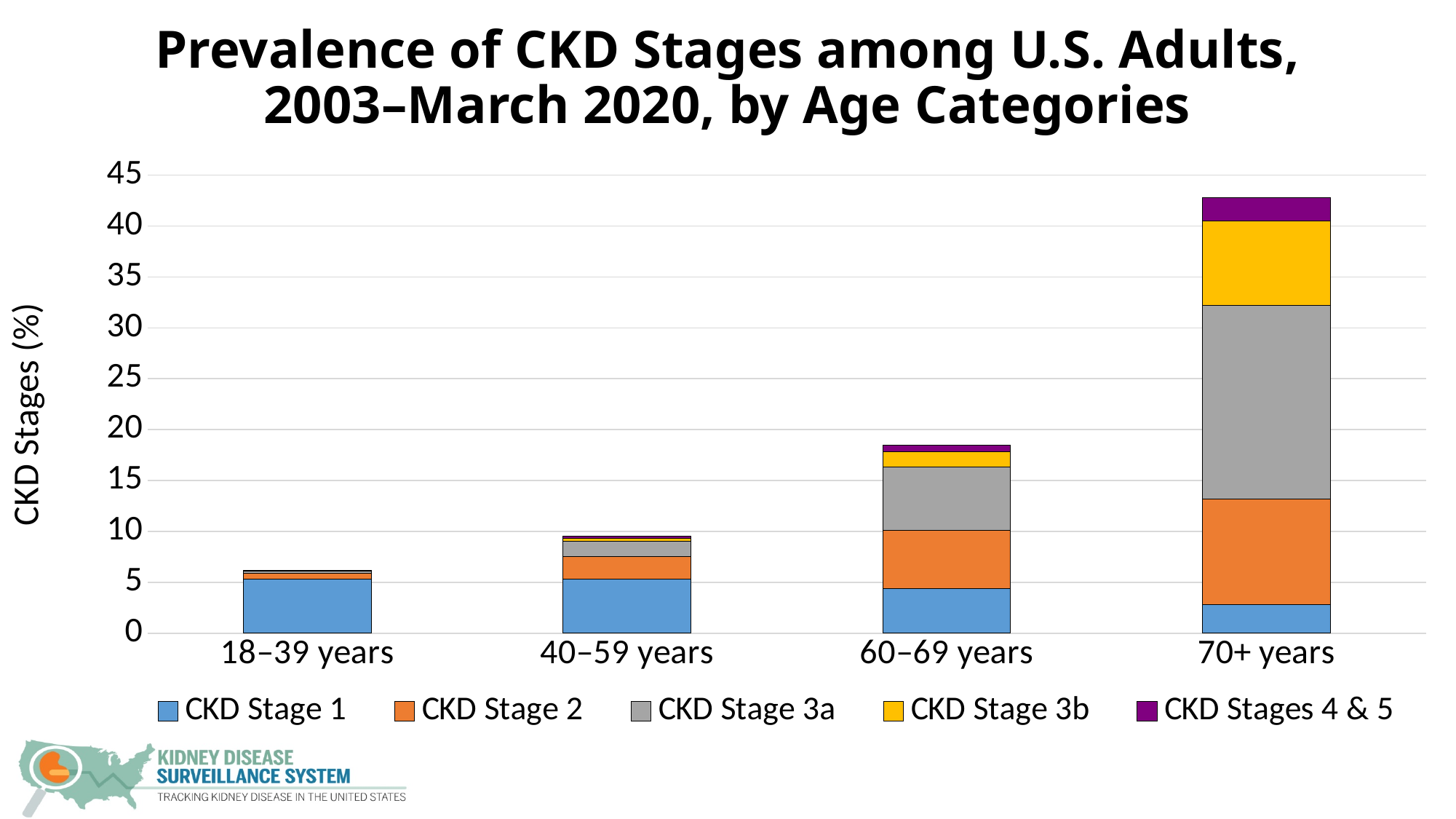
Which age category has the lowest total CKD prevalence? 18–39 years Which colour represents CKD Stage 3b in the legend? Yellow Which has the larger total CKD prevalence, 60–69 years or 70+ years? 70+ years Is the total CKD prevalence for 18–39 years greater or less than 5? greater Do the total bar heights rise or fall as age category increases along the x axis? Rise What is the label of the y axis? CKD Stages (%) Is the total CKD prevalence for 60–69 years greater or less than 20? less How many series does the legend list? 5 Is the total CKD prevalence for 70+ years greater or less than 40? greater Which age category has the highest total CKD prevalence? 70+ years What kind of chart is shown on the slide? Stacked bar chart How many age categories are shown on the x axis? 4